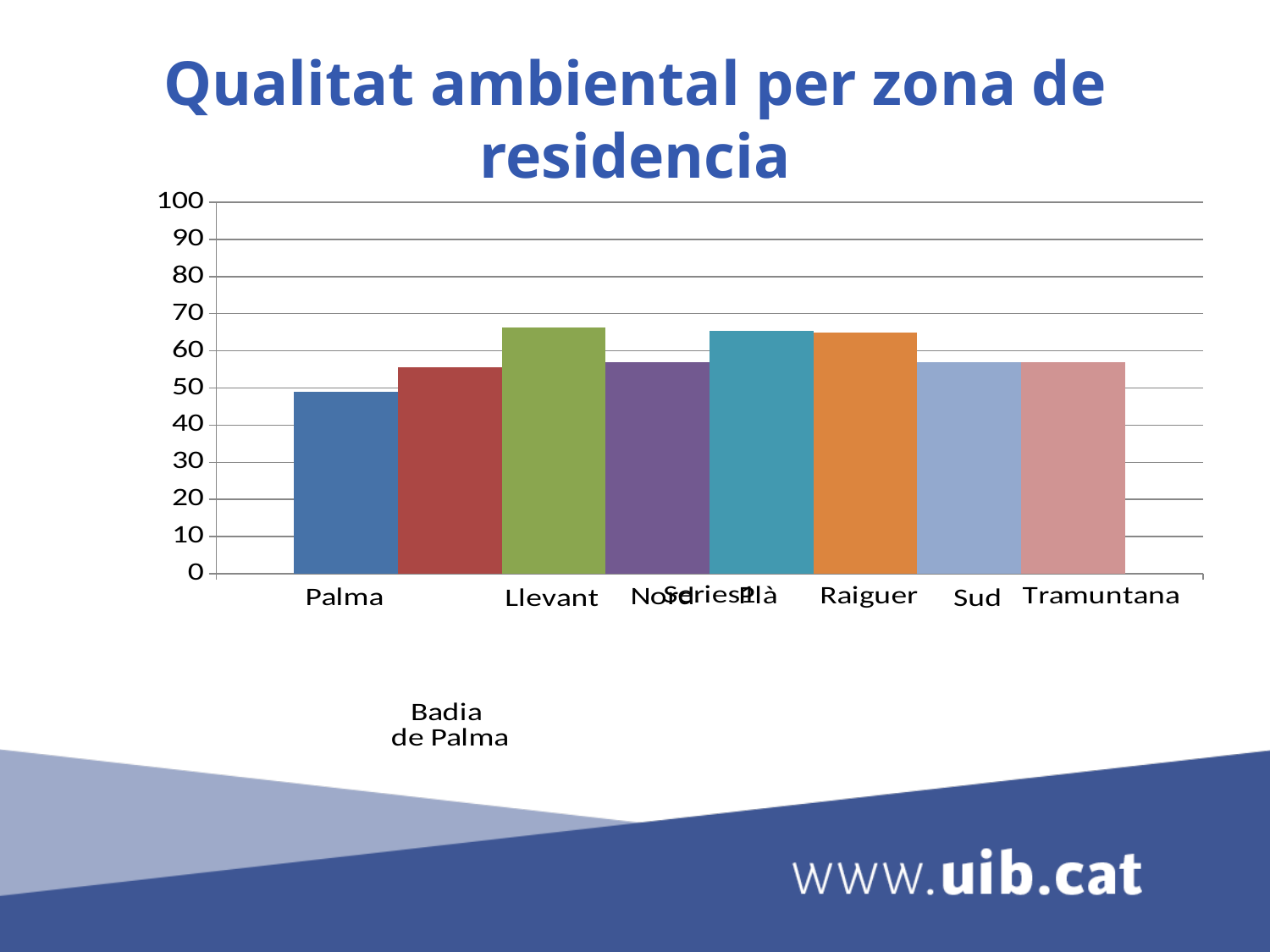
Which zone has the lowest value in the chart? Palma How many bars are plotted in the chart? 8 Is the value for Badia de Palma greater or less than 50? greater What kind of chart is shown on the slide? bar chart Is the value for Llevant greater or less than 60? greater Which has a larger value, Raiguer or Sud? Raiguer What is the title of the chart? Qualitat ambiental per zona de residencia Is the value for Tramuntana greater or less than 70? less Which has a larger value, Llevant or Palma? Llevant